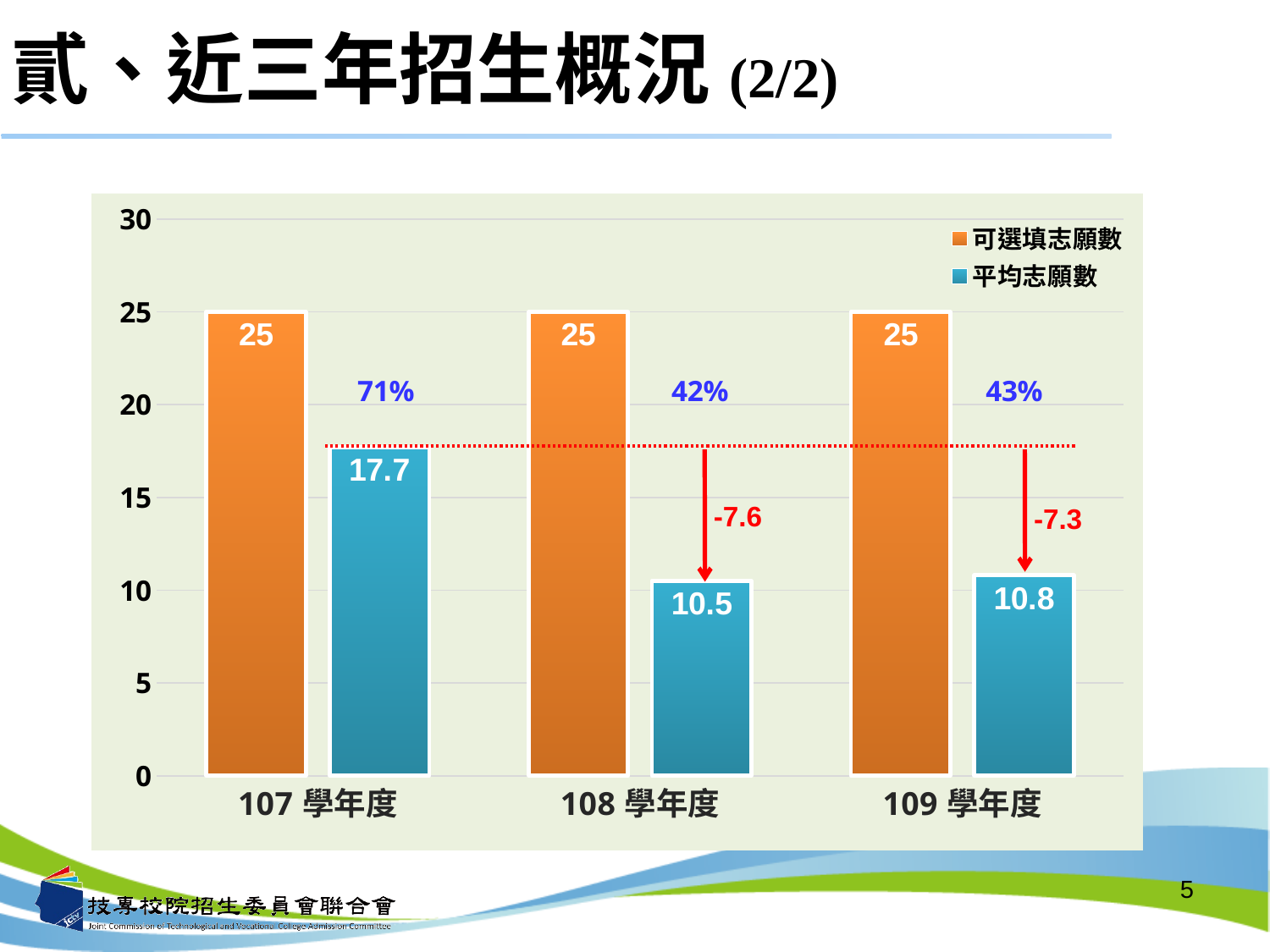
What is the difference between 可選填志願數 and 平均志願數 for 107 學年度? 7.3 What is the value of 平均志願數 for 109 學年度? 10.8 What kind of chart is shown on the slide? bar chart Which academic year has the highest 平均志願數? 107 學年度 What is the value of 平均志願數 for 108 學年度? 10.5 What is the value of 平均志願數 for 107 學年度? 17.7 How many series does the legend list? 2 What is the value of 可選填志願數 for 109 學年度? 25 What percentage label is shown above the 平均志願數 bar for 108 學年度? 42% Which is larger, the 平均志願數 for 107 學年度 or for 109 學年度? 107 學年度 Which academic year has the lowest 平均志願數? 108 學年度 How many academic years are shown on the x axis? 3